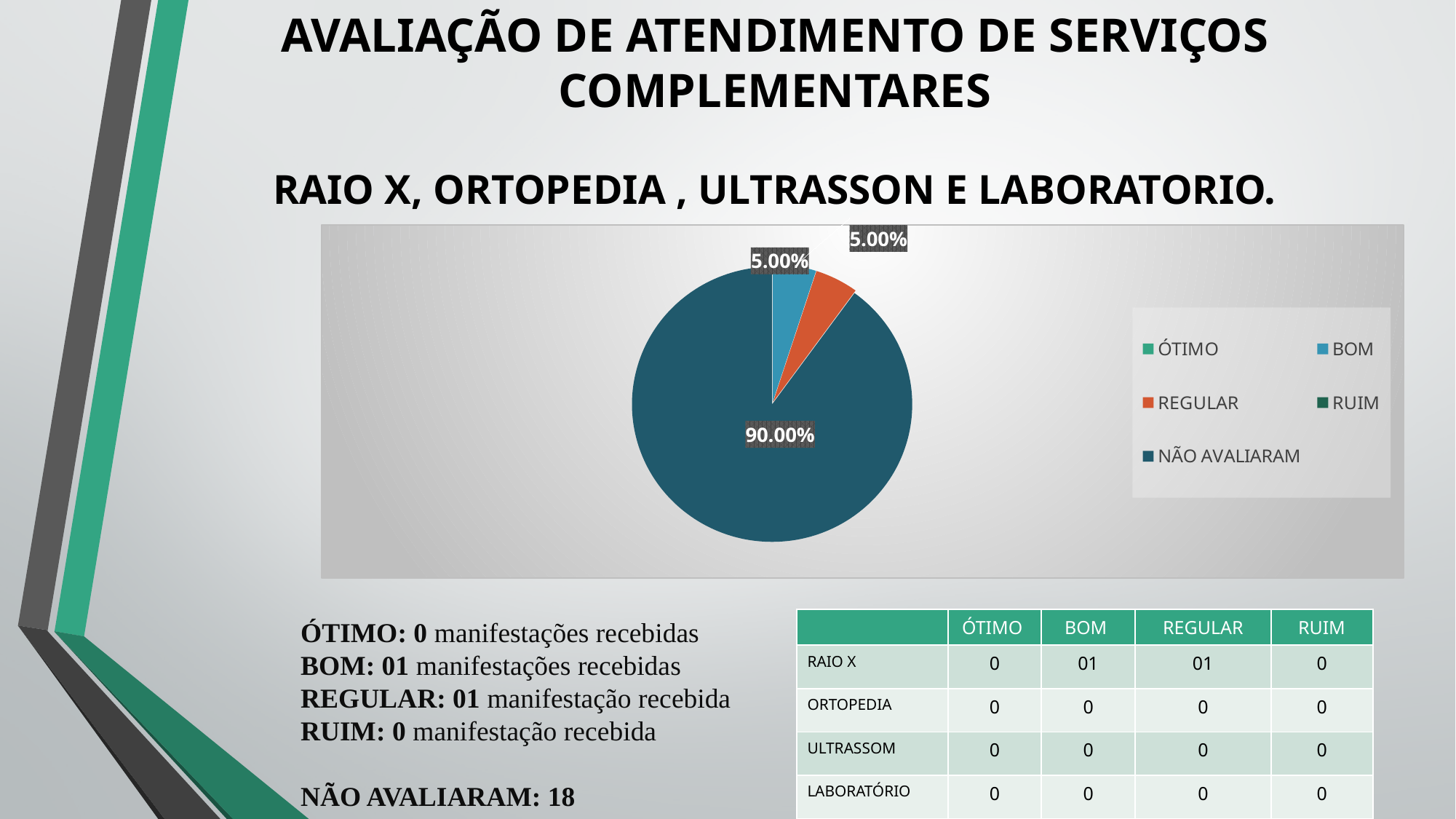
How many entries does the pie chart's legend list? 5 What is the difference between the NÃO AVALIARAM share and the BOM share in the pie chart? 85.00% What percentage does the pie chart show for REGULAR? 5.00% How many slices in the pie chart have a percentage label? 3 What kind of chart is shown on the slide? pie chart Which legend entry in the pie chart is shown in light blue? BOM Which category has the largest slice in the pie chart? NÃO AVALIARAM What percentage does the pie chart show for BOM? 5.00% Which legend entry in the pie chart is shown in orange? REGULAR What is the combined share of the BOM and REGULAR slices in the pie chart? 10.00% Which is larger in the pie chart, the NÃO AVALIARAM slice or the REGULAR slice? NÃO AVALIARAM What percentage does the pie chart show for NÃO AVALIARAM? 90.00%